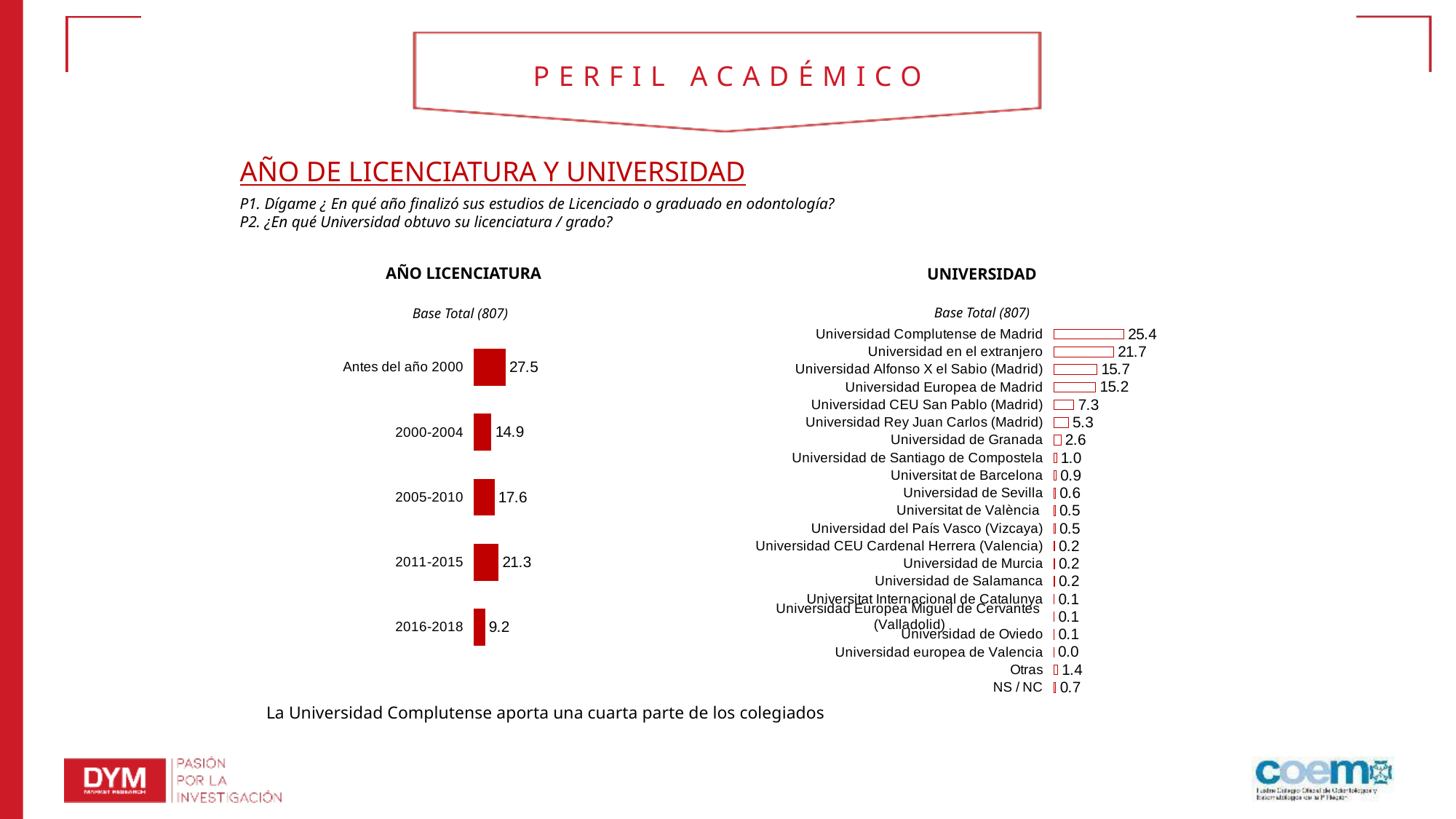
In the AÑO LICENCIATURA chart, what is the value for 2011-2015? 21.3 In the UNIVERSIDAD chart, what is the value for Universidad Complutense de Madrid? 25.4 In the AÑO LICENCIATURA chart, which category has the highest value? Antes del año 2000 In the UNIVERSIDAD chart, what is the difference between Universidad Complutense de Madrid and Universidad en el extranjero? 3.7 In the UNIVERSIDAD chart, which is larger: Universidad en el extranjero or Universidad Europea de Madrid? Universidad en el extranjero In the AÑO LICENCIATURA chart, what is the difference between the values for Antes del año 2000 and 2016-2018? 18.3 What base total is shown for the UNIVERSIDAD chart? 807 What kind of chart is the AÑO LICENCIATURA chart? Bar chart In the AÑO LICENCIATURA chart, how many categories are shown? 5 In the AÑO LICENCIATURA chart, which category has the lowest value? 2016-2018 In the UNIVERSIDAD chart, which university has the highest value? Universidad Complutense de Madrid In the UNIVERSIDAD chart, what is the value for Universidad CEU San Pablo (Madrid)? 7.3